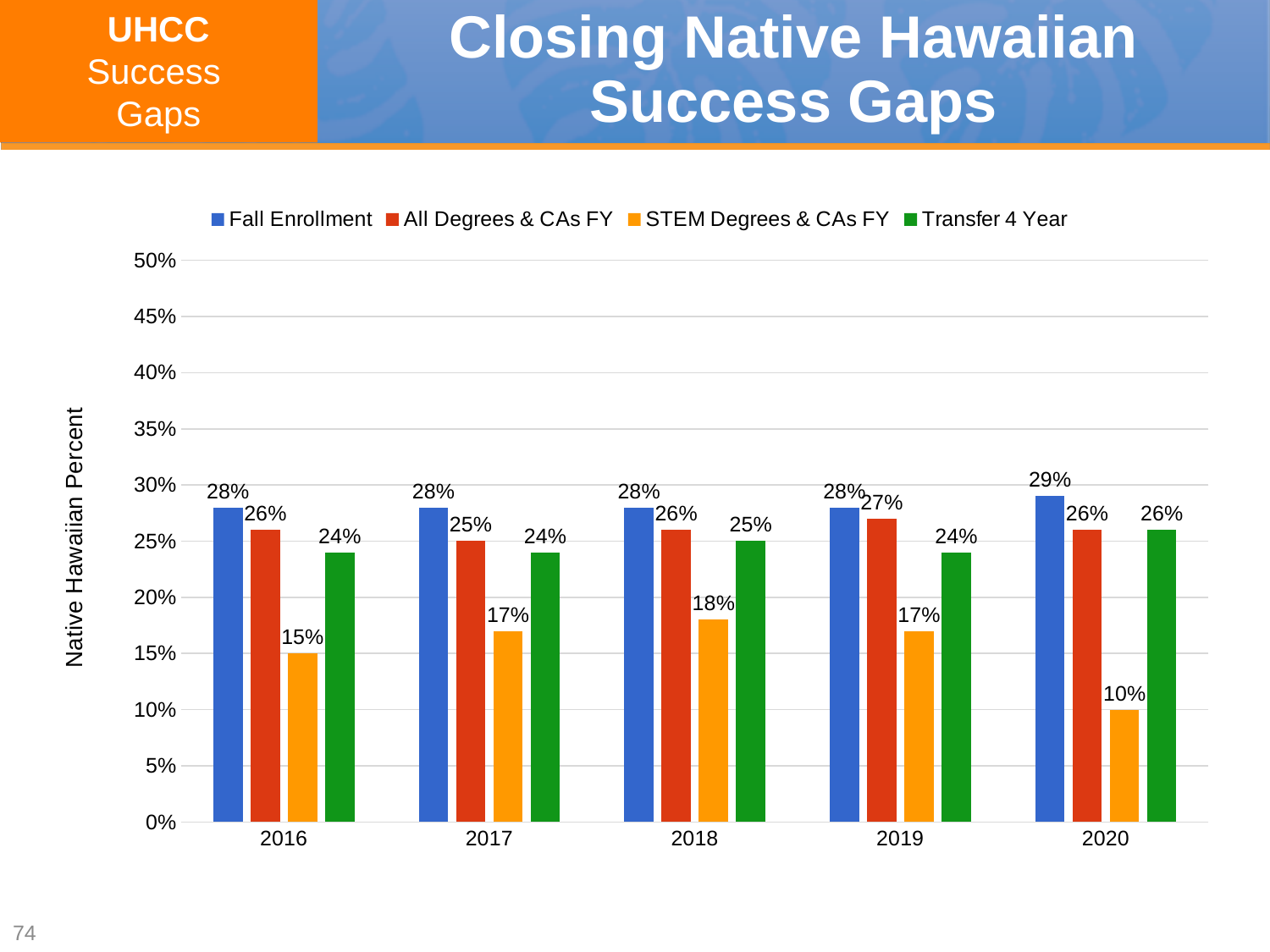
What kind of chart is shown on the slide? Bar chart What is the Transfer 4 Year value for 2018? 25% How many years are shown on the x axis? 5 What is the STEM Degrees & CAs FY value for 2016? 15% How many series does the legend list? 4 In which year is the STEM Degrees & CAs FY value lowest? 2020 What is the difference between the Fall Enrollment and STEM Degrees & CAs FY values in 2020? 19% What is the Fall Enrollment value for 2020? 29% In which year is the Fall Enrollment value highest? 2020 Which is larger in 2017: All Degrees & CAs FY or Transfer 4 Year? All Degrees & CAs FY What is the label of the vertical axis? Native Hawaiian Percent What is the All Degrees & CAs FY value for 2019? 27%